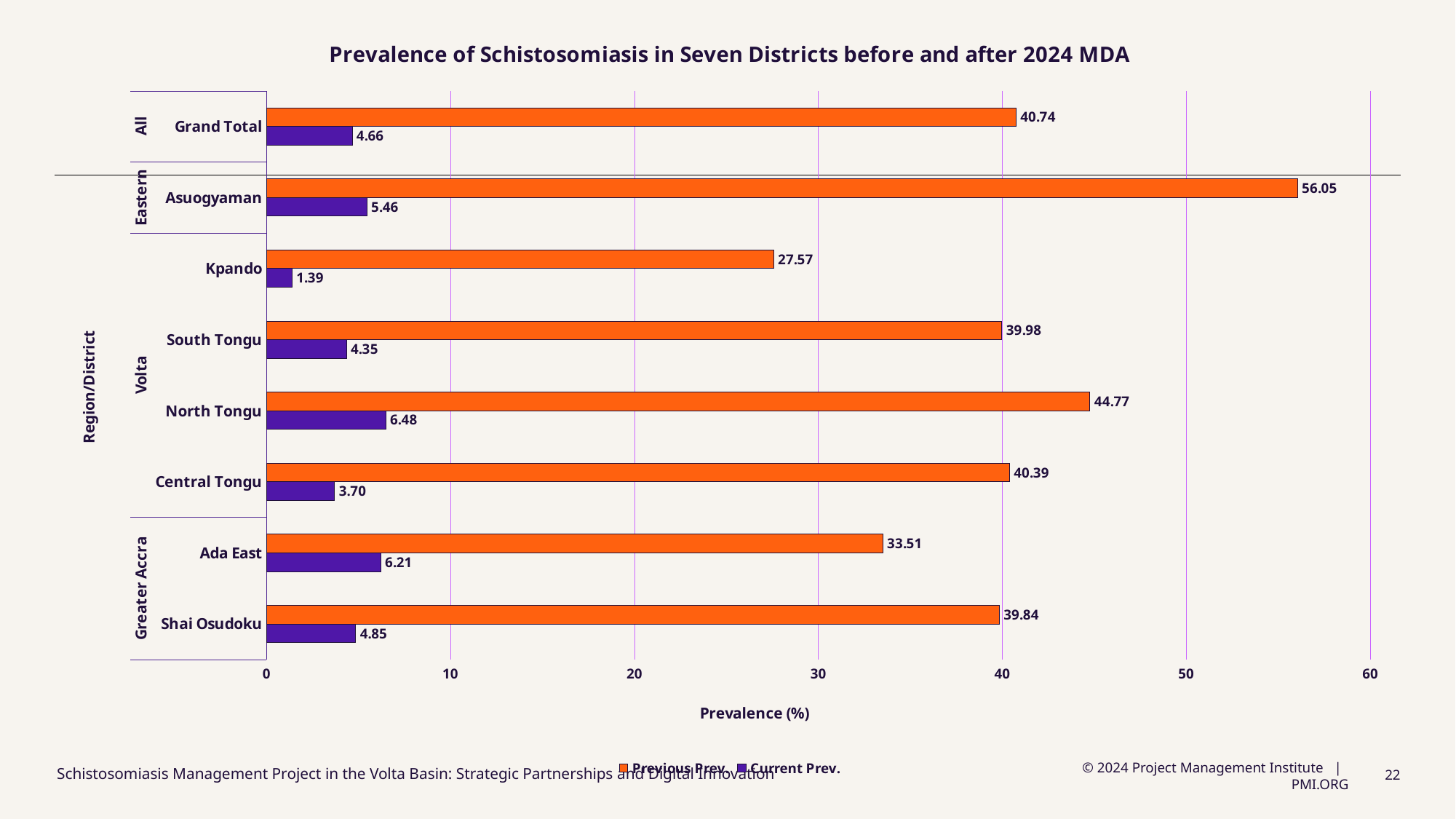
What kind of chart is shown on the slide? bar chart Which district has the highest Previous Prev. value? Asuogyaman What is the Previous Prev. value for Asuogyaman? 56.05 What is the Current Prev. value for Kpando? 1.39 Which has the larger Current Prev. value, Ada East or Shai Osudoku? Ada East Which district has the lowest Current Prev. value? Kpando Which district has the highest Current Prev. value? North Tongu What is the difference between the Previous Prev. and Current Prev. values for Asuogyaman? 50.59 What is the Previous Prev. value for Grand Total? 40.74 Is the Previous Prev. value for Kpando greater or less than 30? less How many series does the legend list? 2 How many categories are shown on the y axis of the chart? 8